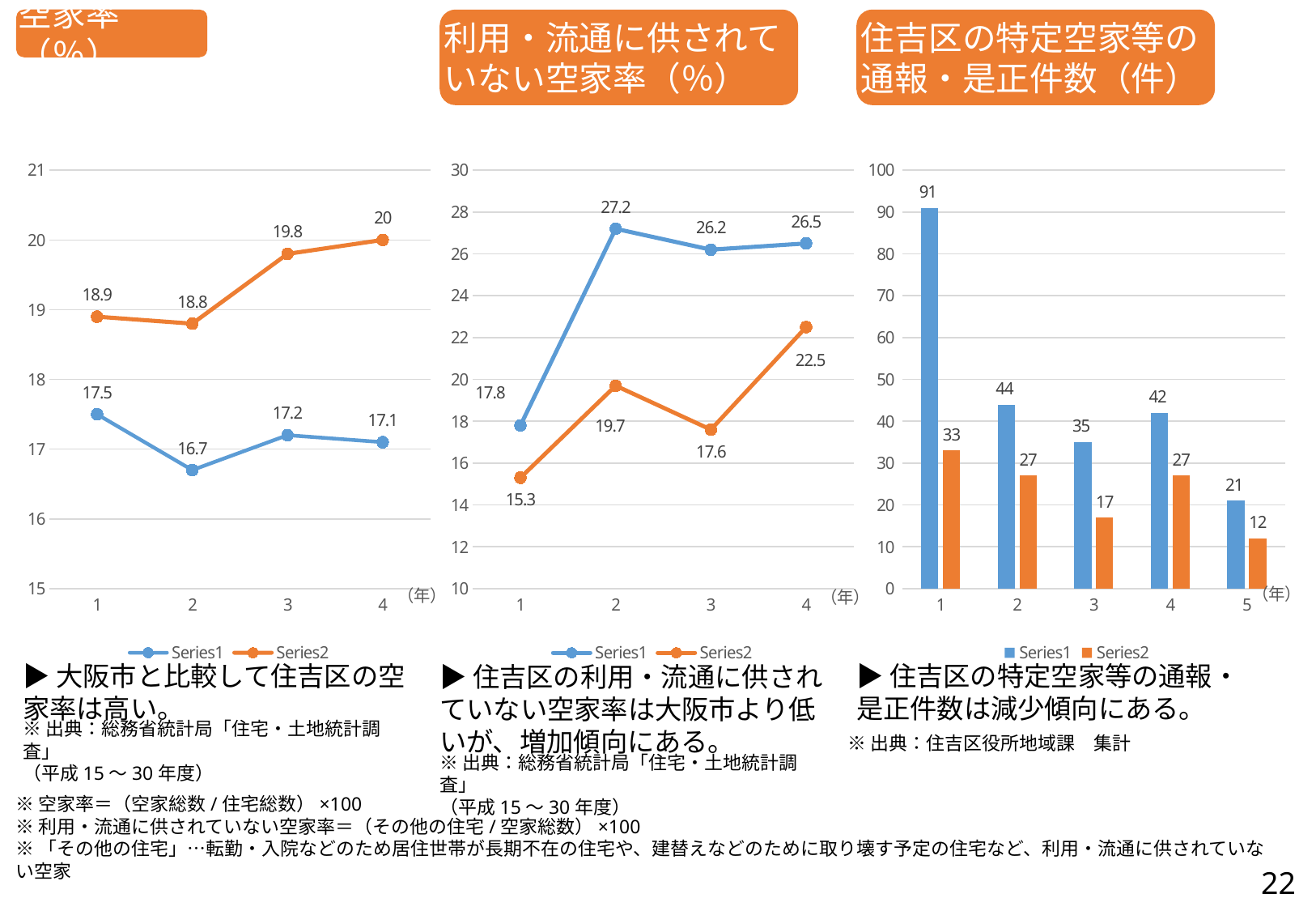
In the right chart (住吉区の特定空家等の通報・是正件数), what is the value of Series1 at x = 1? 91 In the middle chart (利用・流通に供されていない空家率), at which x value is Series2 lowest? 1 In the left chart (空家率), what is the value of Series2 at x = 4? 20 In the left chart (空家率), what is the difference between Series2 and Series1 at x = 1? 1.4 In the left chart (空家率), what kind of chart is shown? line chart In the middle chart (利用・流通に供されていない空家率), what is the value of Series1 at x = 2? 27.2 In the right chart (住吉区の特定空家等の通報・是正件数), what kind of chart is shown? bar chart In the left chart (空家率), what is the value of Series1 at x = 2? 16.7 In the right chart (住吉区の特定空家等の通報・是正件数), which x value has the lowest Series2 value? 5 In the middle chart (利用・流通に供されていない空家率), what is the difference between Series1 and Series2 at x = 4? 4 In the right chart (住吉区の特定空家等の通報・是正件数), how many categories are on the x axis? 5 In the middle chart (利用・流通に供されていない空家率), how many series does the legend list? 2